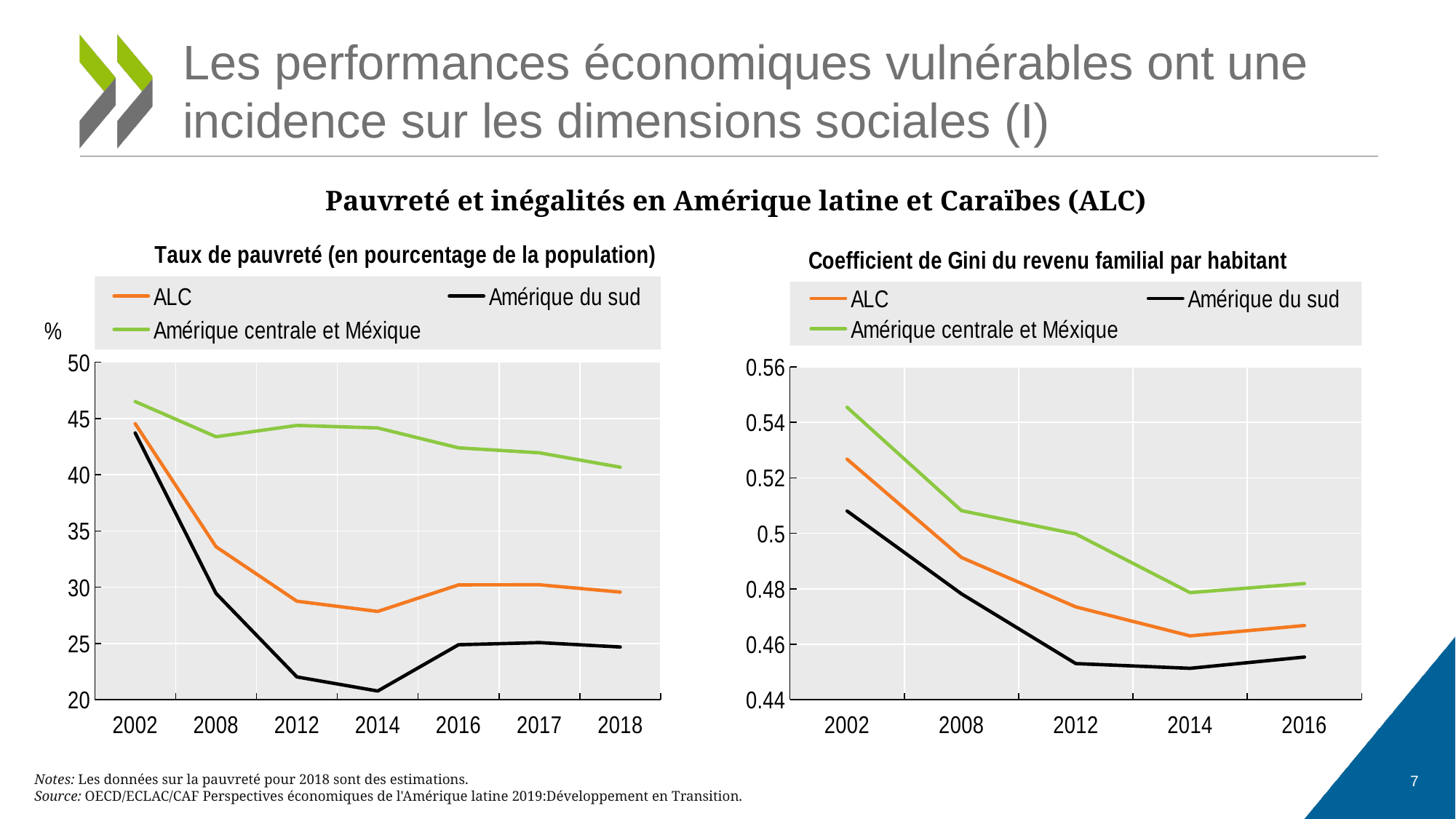
In the 'Coefficient de Gini' chart on the right, which series has the lowest value in 2016? Amérique du sud How many series does the legend of the 'Coefficient de Gini' chart on the right list? 3 In the 'Coefficient de Gini' chart on the right, is the value for Amérique du sud in 2014 greater or less than 0.46? less In the 'Taux de pauvreté' chart on the left, is the value for Amérique centrale et Méxique in 2002 greater or less than 45? greater How many years are shown on the x axis of the 'Coefficient de Gini' chart on the right? 5 In the 'Taux de pauvreté' chart on the left, which colour is used for the ALC series? orange What kind of chart is the 'Taux de pauvreté' chart on the left? line chart In the 'Taux de pauvreté' chart on the left, is the value for Amérique du sud in 2014 greater or less than 25? less In the 'Taux de pauvreté' chart on the left, which series has the highest value in 2018? Amérique centrale et Méxique In the 'Coefficient de Gini' chart on the right, does the ALC line rise or fall from 2002 to 2014? fall How many years are shown on the x axis of the 'Taux de pauvreté' chart on the left? 7